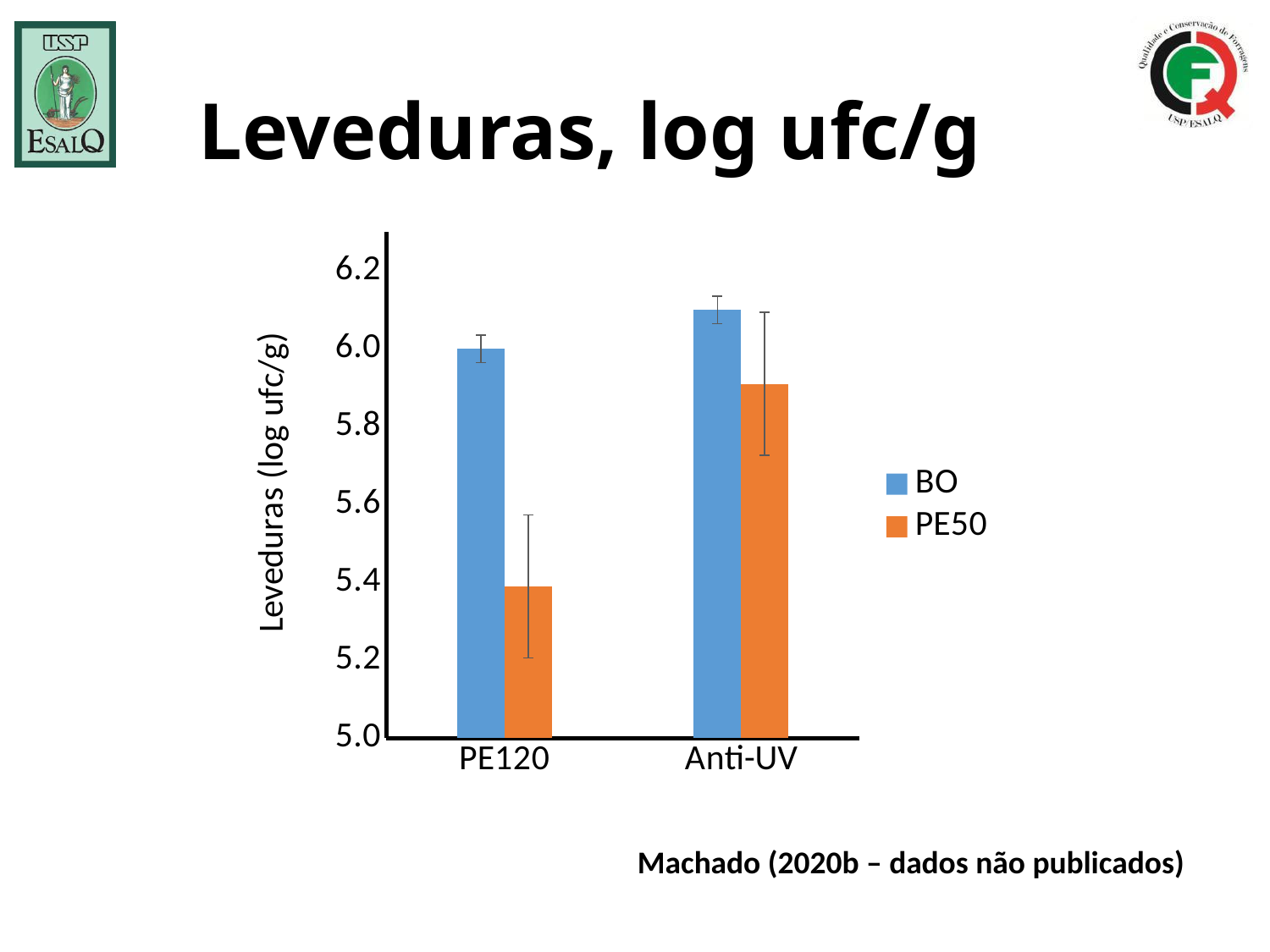
What kind of chart is shown on the slide? bar chart For Anti-UV, which series has the larger value, BO or PE50? BO For PE120, which series has the larger value, BO or PE50? BO Is the value for BO at Anti-UV greater or less than 6.0? greater Is the value for PE50 at Anti-UV greater or less than 5.8? greater Is the value for PE50 at PE120 greater or less than 5.6? less What is the title of the y axis of the chart? Leveduras (log ufc/g) Which bar is the highest in the chart? BO for Anti-UV How many categories are shown on the x axis of the chart? 2 How many series does the chart's legend list? 2 Which series are listed in the chart's legend? BO and PE50 Which bar is the lowest in the chart? PE50 for PE120